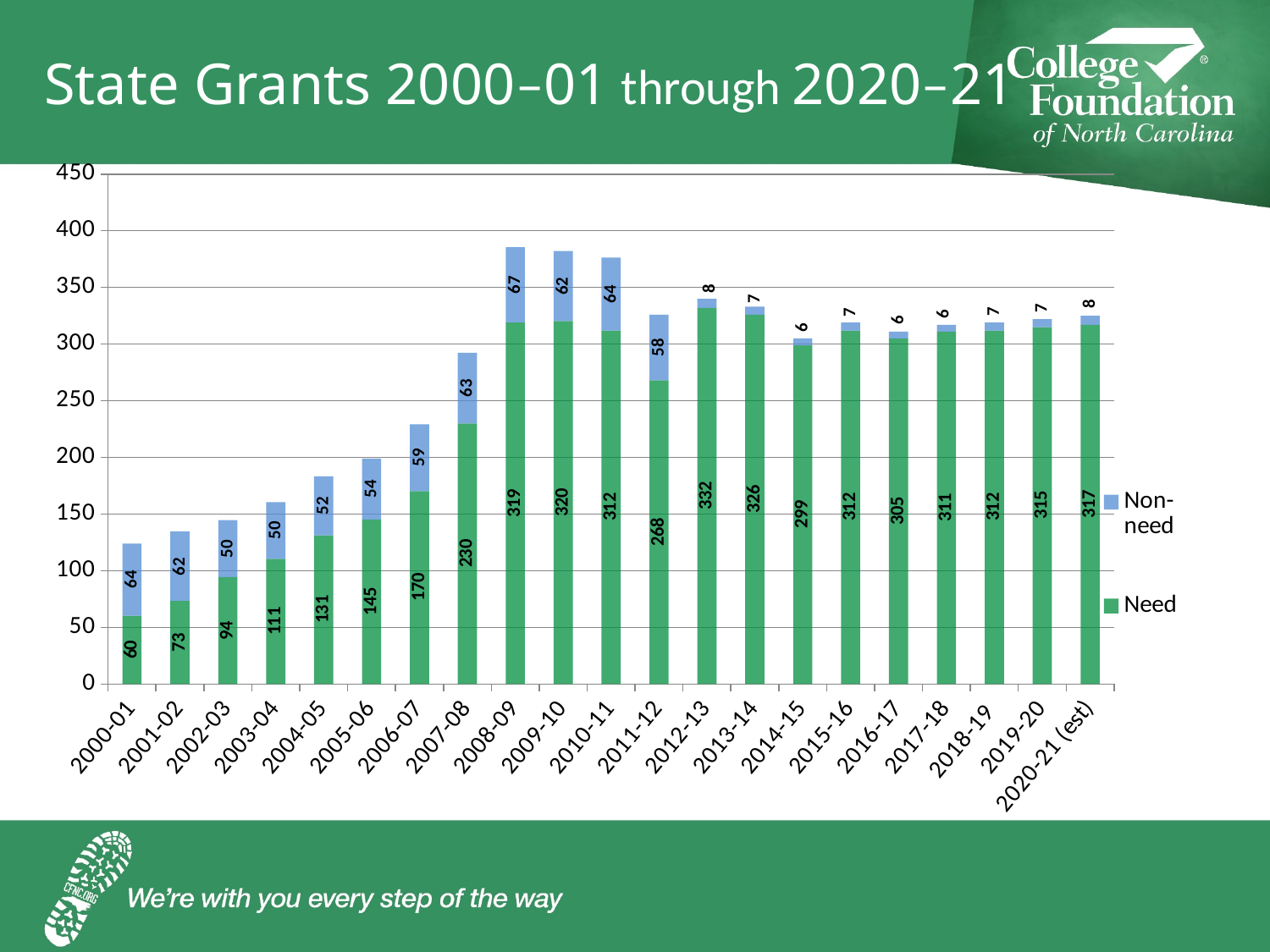
Which series is shown in green? Need What is the Need value for 2007-08? 230 What is the Non-need value for 2008-09? 67 What is the total of the stacked bar for 2010-11? 376 What is the difference between the Need values for 2009-10 and 2000-01? 260 Which is larger, the Need value for 2011-12 or the Need value for 2014-15? 2014-15 Which year has the highest Need value? 2012-13 Which year has the lowest Need value? 2000-01 What kind of chart is shown on the slide? Stacked bar chart How many years are shown on the x axis? 21 Do the Need values rise or fall from 2000-01 to 2008-09? Rise How many series does the legend list? 2